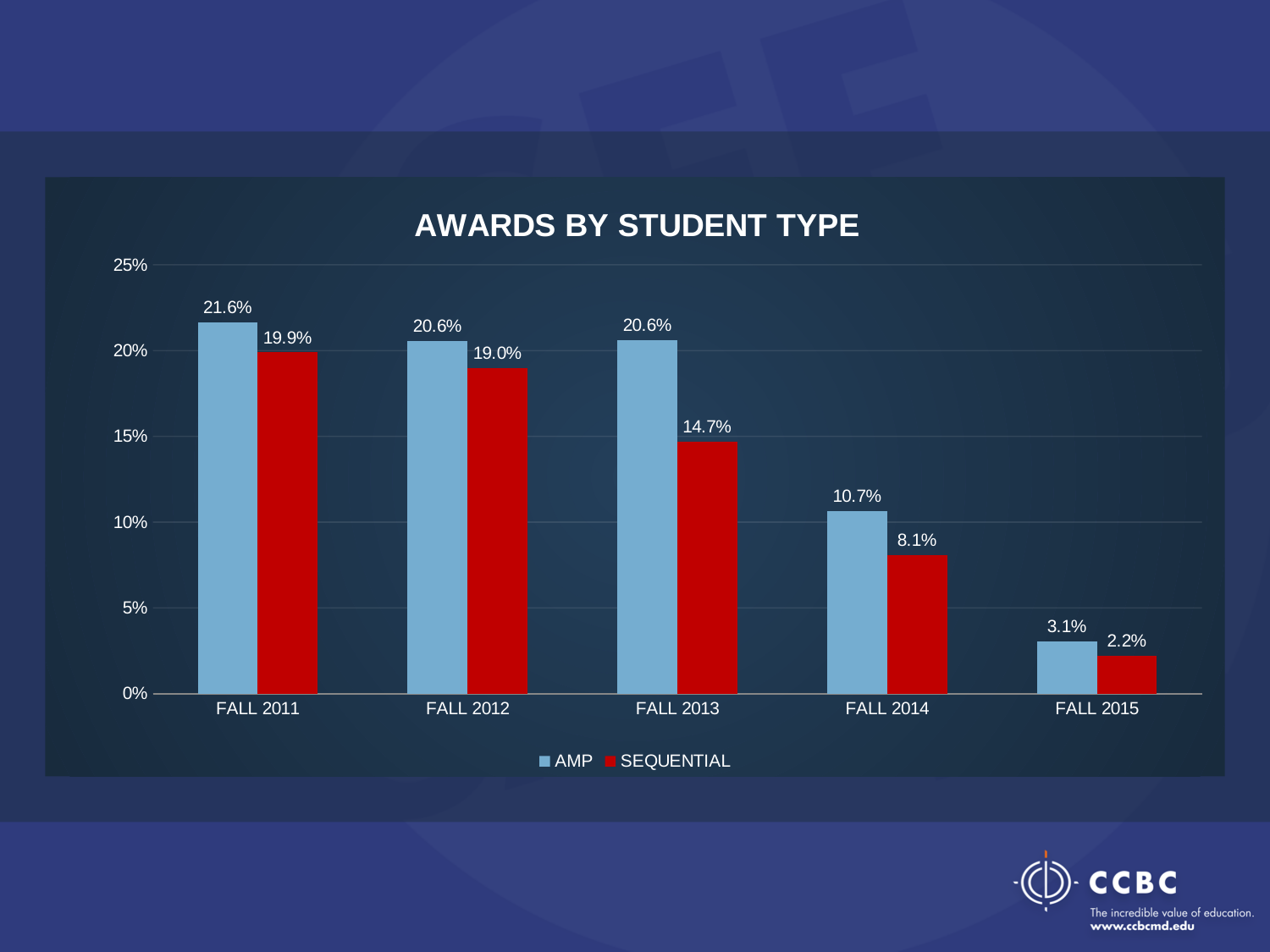
What is the SEQUENTIAL value for FALL 2013? 14.7% Which is larger for FALL 2014, the AMP value or the SEQUENTIAL value? AMP What is the difference between the AMP and SEQUENTIAL values for FALL 2013? 5.9% Is the SEQUENTIAL value for FALL 2012 greater or less than 15%? greater What is the AMP value for FALL 2014? 10.7% What is the AMP value for FALL 2011? 21.6% What kind of chart is shown on the slide? Bar chart Which term has the highest AMP value? FALL 2011 Which term has the lowest SEQUENTIAL value? FALL 2015 How many terms are shown on the x axis? 5 Do the AMP values rise or fall from FALL 2011 to FALL 2015? Fall How many series does the legend list? 2